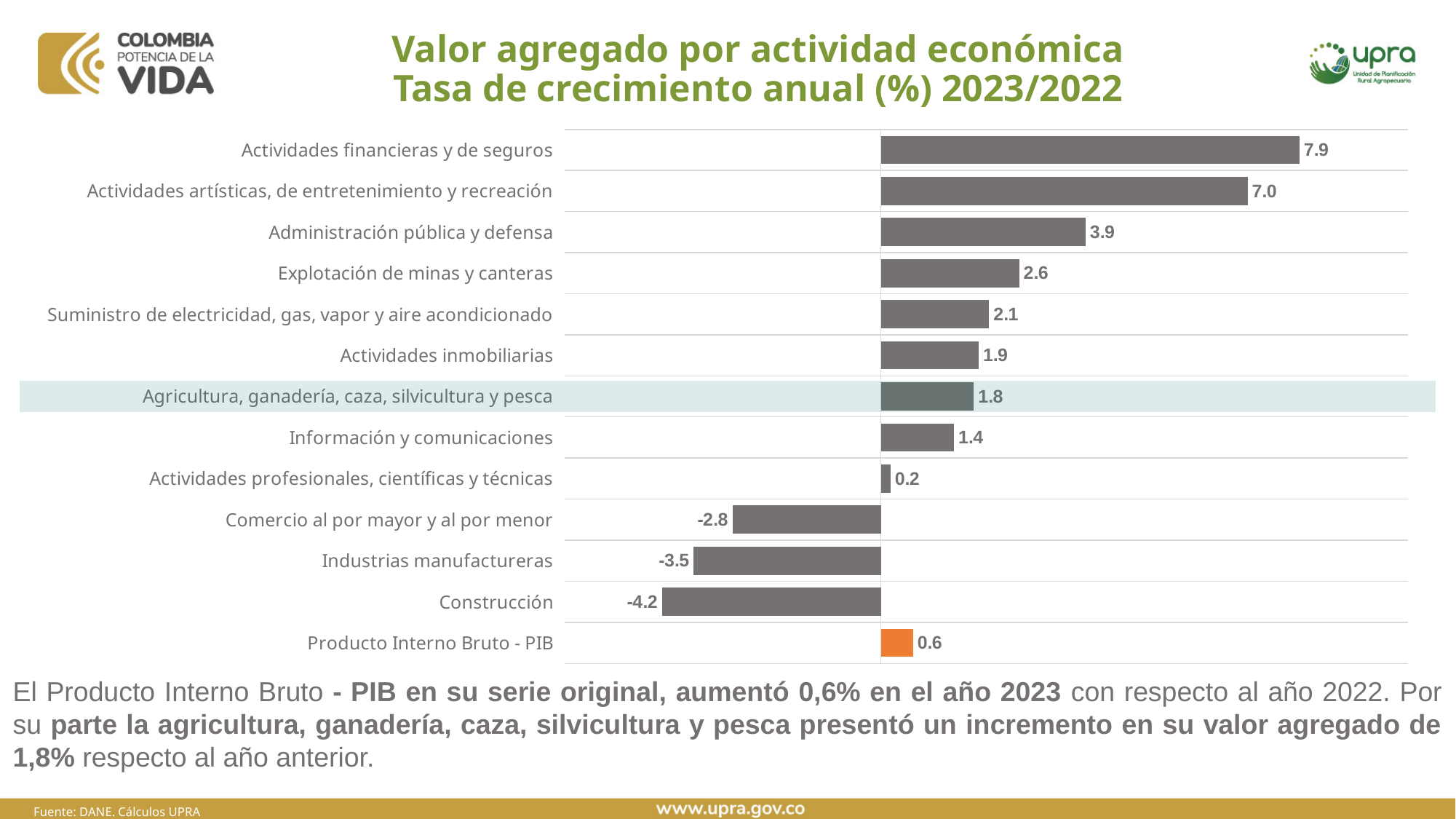
What type of chart is shown on the slide? Bar chart What is the annual growth rate shown for Actividades financieras y de seguros? 7.9 How many activities show a negative growth rate? 3 What value is shown for Agricultura, ganadería, caza, silvicultura y pesca? 1.8 Which bar is coloured orange instead of grey? Producto Interno Bruto - PIB What value is shown for Producto Interno Bruto - PIB? 0.6 Which activity has the highest growth rate in the chart? Actividades financieras y de seguros Which activity has the lowest growth rate in the chart? Construcción What is the difference between the values for Actividades financieras y de seguros and Actividades artísticas, de entretenimiento y recreación? 0.9 What value is shown for Construcción? -4.2 Which is larger, the value for Explotación de minas y canteras or the value for Actividades inmobiliarias? Explotación de minas y canteras How many categories (bars) are shown in the chart? 13